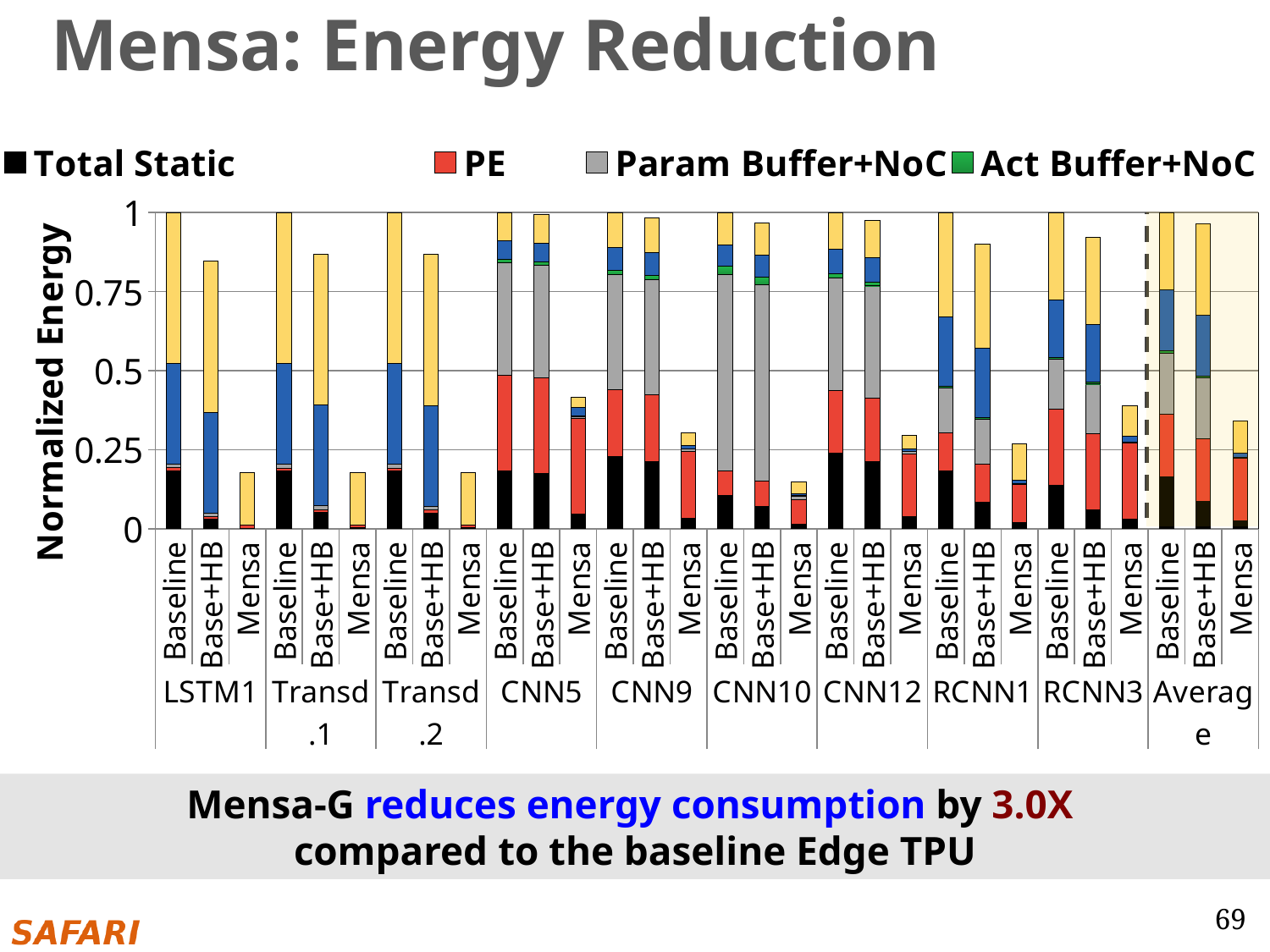
What type of chart is shown on the slide? Stacked bar chart Is the total value of the Base+HB bar for LSTM1 greater or less than 0.75? greater Is the total value of the Mensa bar for CNN10 greater or less than 0.25? less Which is larger: the total of the Mensa bar for CNN5 or the Mensa bar for LSTM1? Mensa bar for CNN5 Which is larger: the total of the Base+HB bar for CNN5 or the Base+HB bar for LSTM1? Base+HB bar for CNN5 How many workload groups are shown along the x axis? 10 Is the total value of the Mensa bar for LSTM1 greater or less than 0.25? less What is the label of the y axis? Normalized Energy What is the total normalized energy of the Baseline bar for LSTM1? 1